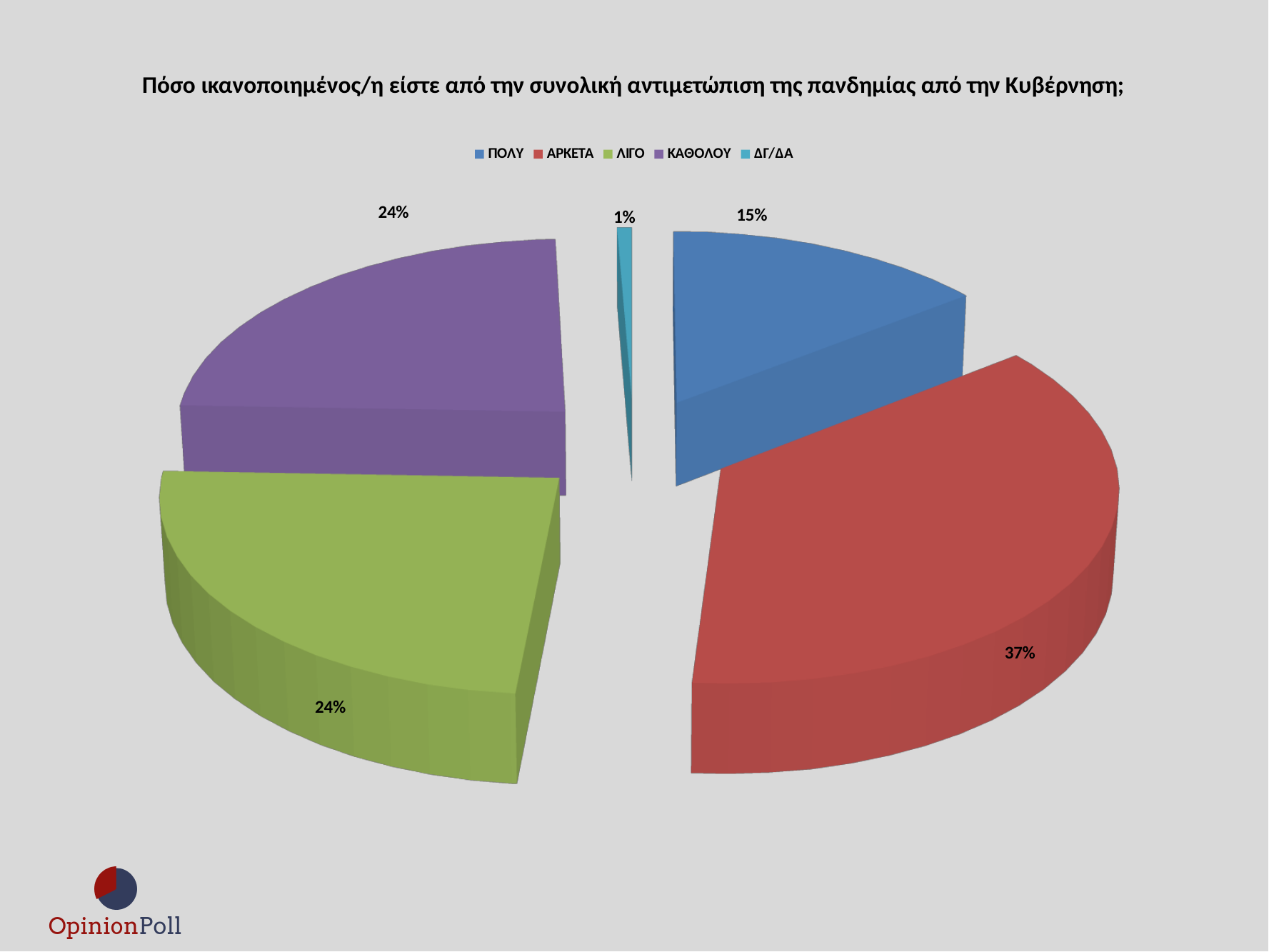
What percentage of respondents answered ΑΡΚΕΤΑ? 37% Which response has the smallest share of the pie? ΔΓ/ΔΑ What percentage of respondents answered ΠΟΛΥ? 15% What is the combined share of ΠΟΛΥ and ΑΡΚΕΤΑ? 52% How many categories does the legend list? 5 What colour is the ΚΑΘΟΛΟΥ slice? purple What is the difference in percentage points between ΑΡΚΕΤΑ and ΠΟΛΥ? 22 What percentage of respondents answered ΛΙΓΟ? 24% What kind of chart is shown on the slide? pie chart Which is larger, the share for ΚΑΘΟΛΟΥ or the share for ΠΟΛΥ? ΚΑΘΟΛΟΥ Which response has the largest share of the pie? ΑΡΚΕΤΑ What percentage of respondents answered ΔΓ/ΔΑ? 1%